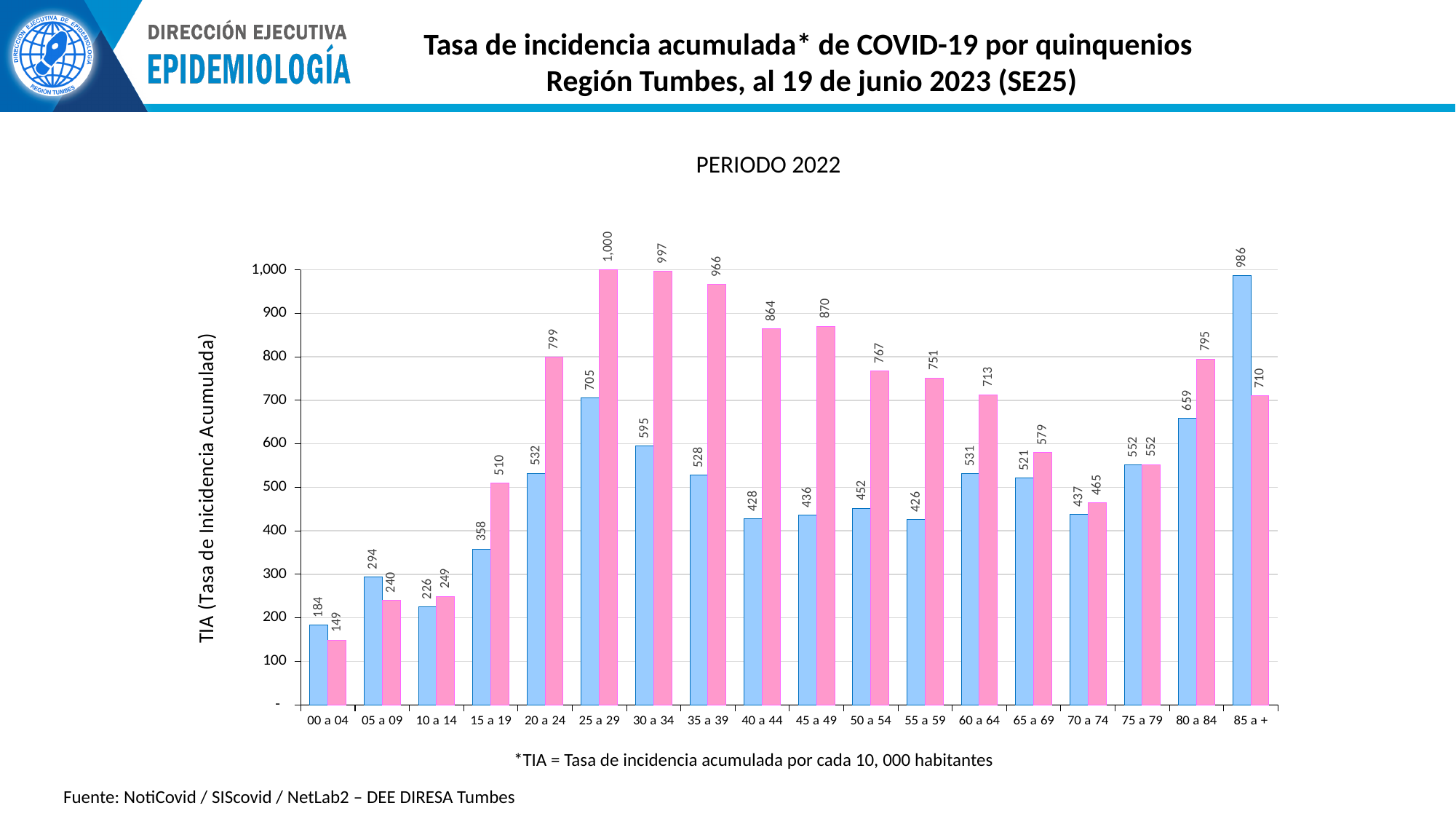
For the 85 a + age group, which bar is larger, blue or pink? blue What is the value of the pink bar for the 40 a 44 age group? 864 What is the value of the blue bar for the 25 a 29 age group? 705 What is the subtitle shown above the chart? PERIODO 2022 What is the difference between the pink and blue bars for the 20 a 24 age group? 267 What type of chart is shown on the slide? bar chart Which age group has the lowest blue bar? 00 a 04 How many age groups are shown on the x axis? 18 Which age group has the highest blue bar? 85 a + Is the pink bar for the 30 a 34 age group greater or less than 900? greater What is the value of the blue bar for the 75 a 79 age group? 552 Which age group has the highest pink bar? 25 a 29